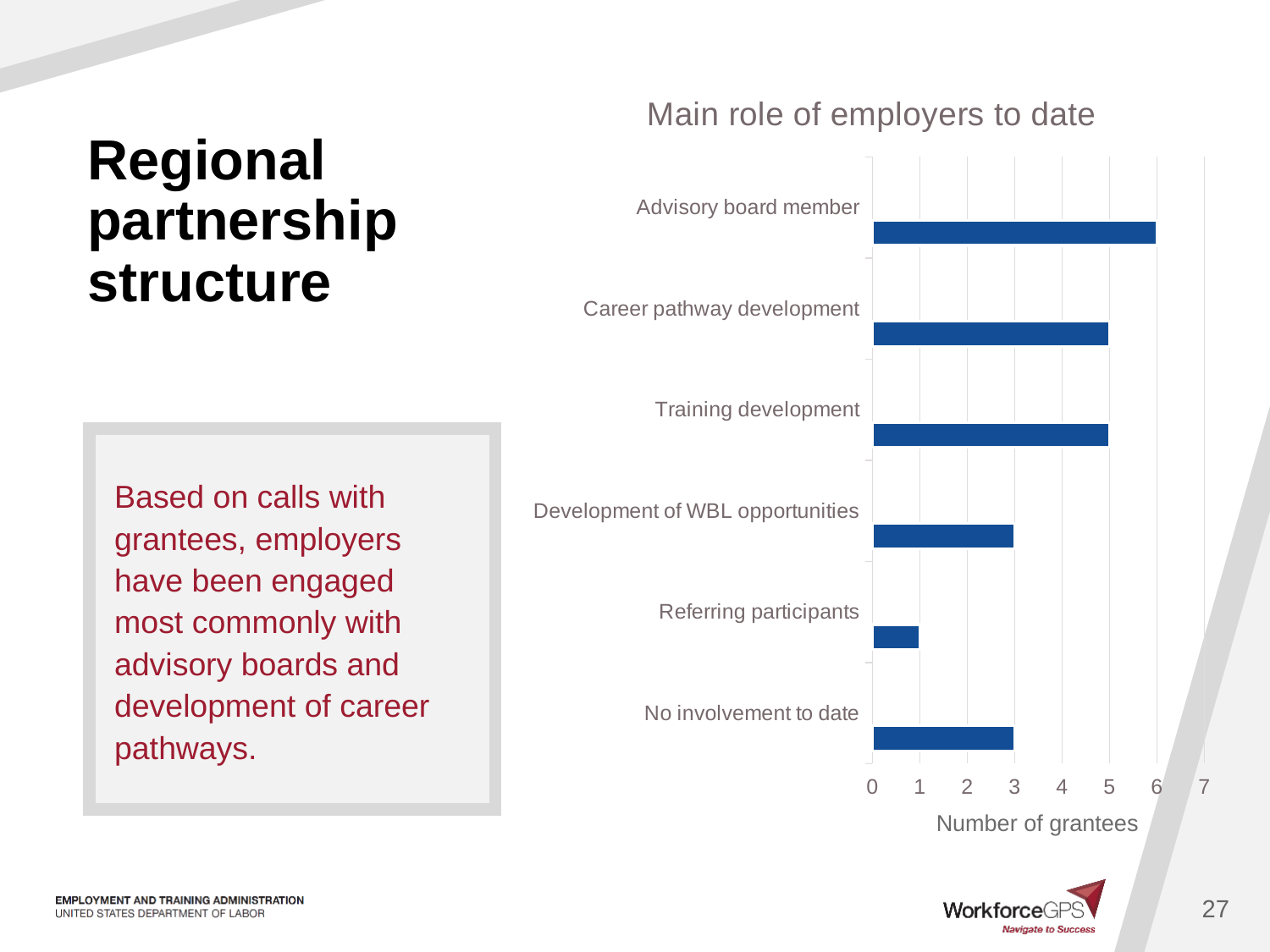
What is the number of grantees for No involvement to date? 3 Which has more grantees, Training development or Referring participants? Training development How many categories does the chart show? 6 What is the number of grantees for Referring participants? 1 What kind of chart is shown on the slide? bar chart What is the title of the chart? Main role of employers to date Which category has the highest number of grantees? Advisory board member Which category has the lowest number of grantees? Referring participants What is the difference in number of grantees between Advisory board member and Development of WBL opportunities? 3 What is the number of grantees for Advisory board member? 6 What is the number of grantees for Career pathway development? 5 What is the label of the horizontal axis? Number of grantees